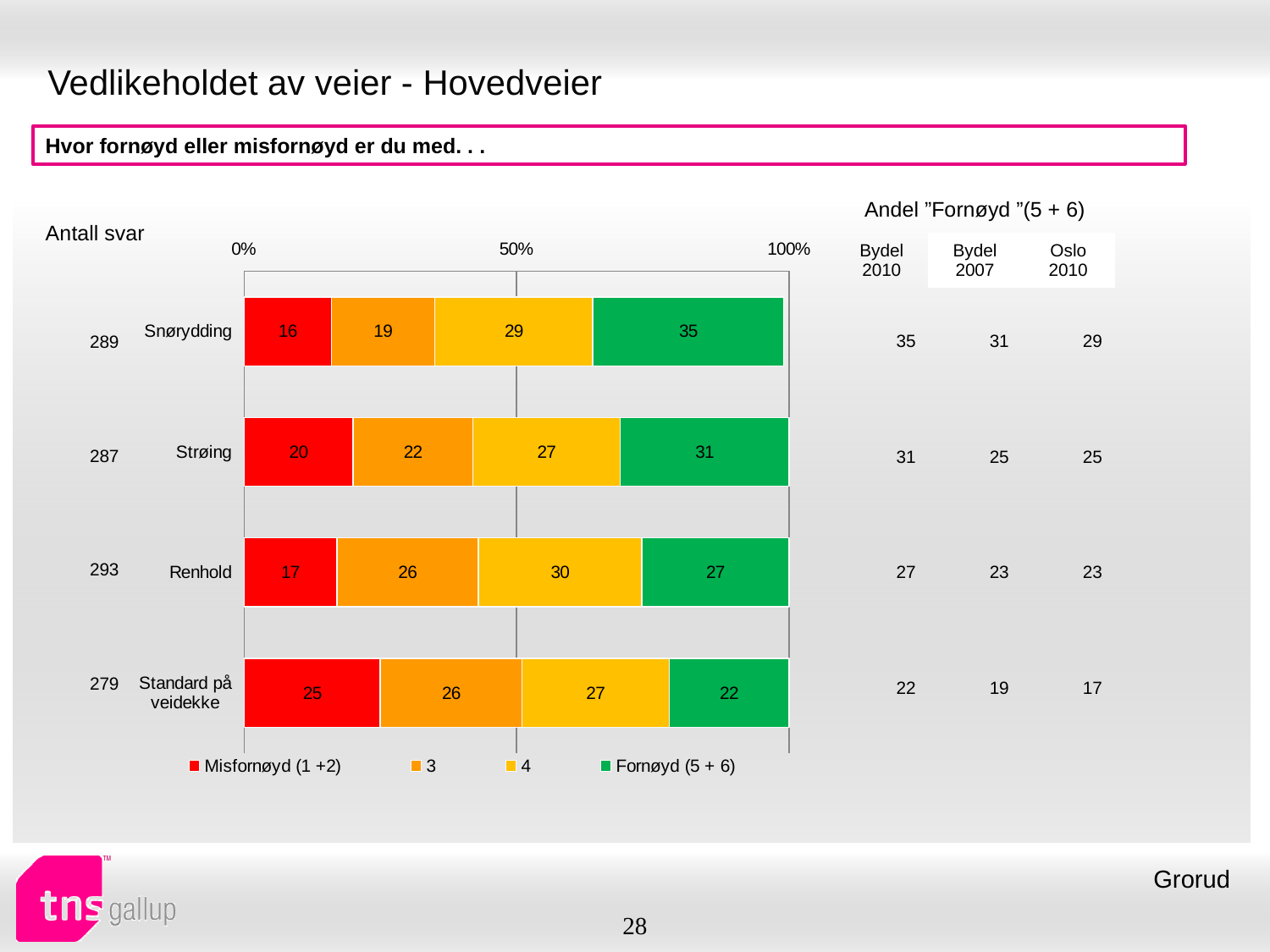
What is the value of the Fornøyd (5 + 6) segment for Snørydding? 35 Which is larger: the Misfornøyd (1 +2) value for Strøing or for Renhold? Strøing What kind of chart is shown on the slide? Stacked bar chart Which category has the lowest Misfornøyd (1 +2) value? Snørydding What is the value of the Misfornøyd (1 +2) segment for Standard på veidekke? 25 What is the value of the '3' segment for Strøing? 22 How many categories are plotted in the chart? 4 What is the difference between the Fornøyd (5 + 6) values for Snørydding and Standard på veidekke? 13 How many series does the legend list? 4 Which category has the highest Fornøyd (5 + 6) value? Snørydding What is the value of the '4' segment for Renhold? 30 What is the total of the stacked bar for Strøing? 100